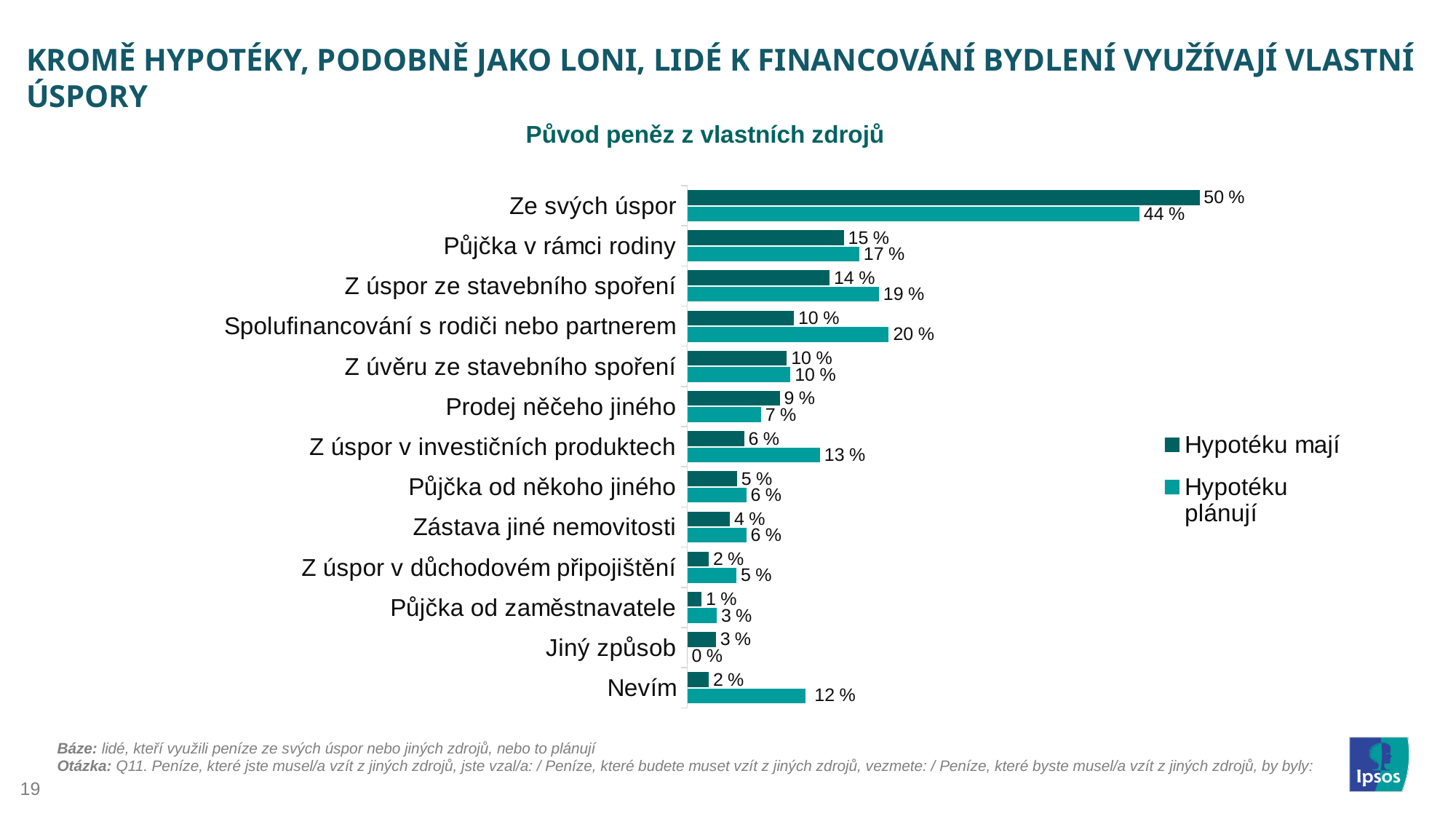
What is the title of the chart? Původ peněz z vlastních zdrojů What is the difference between the "Hypotéku plánují" and "Hypotéku mají" values for "Z úspor v investičních produktech"? 7 % What is the value for "Nevím" in the "Hypotéku plánují" series? 12 % Which category has the highest value in the "Hypotéku plánují" series? Ze svých úspor What is the value for "Ze svých úspor" in the "Hypotéku mají" series? 50 % What kind of chart is shown on the slide? Bar chart Which category has the lowest value in the "Hypotéku plánují" series? Jiný způsob For "Z úspor ze stavebního spoření", which series has the larger value: "Hypotéku mají" or "Hypotéku plánují"? Hypotéku plánují How many series does the legend list? 2 What is the difference between the "Hypotéku mají" and "Hypotéku plánují" values for "Ze svých úspor"? 6 % How many categories are shown on the chart? 13 What is the value for "Spolufinancování s rodiči nebo partnerem" in the "Hypotéku plánují" series? 20 %